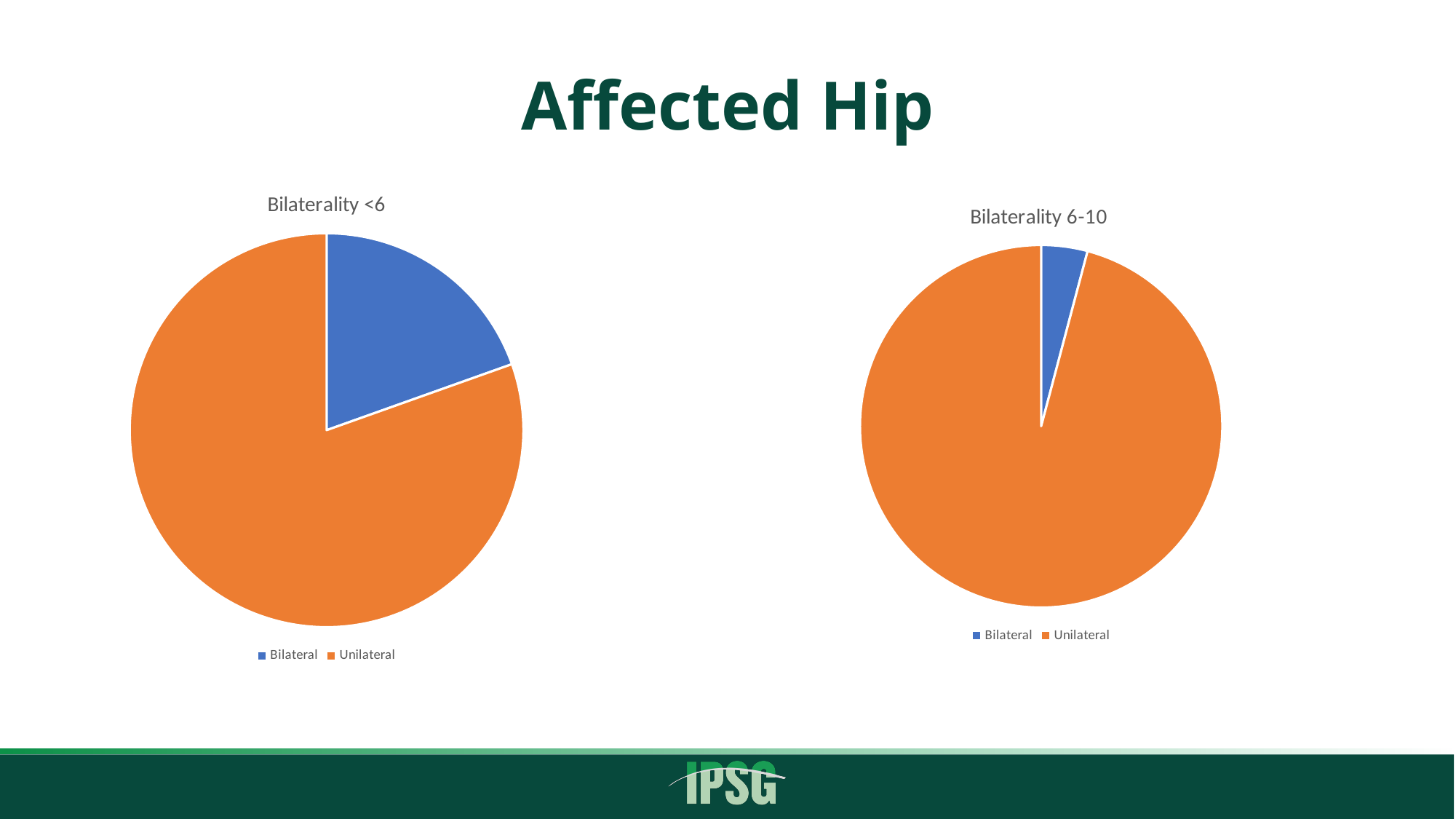
How many entries does the legend of the 'Bilaterality 6-10' chart list? 2 In the 'Bilaterality 6-10' chart, which slice is the largest? Unilateral In the 'Bilaterality 6-10' chart, which slice is the smallest? Bilateral What kind of chart is the 'Bilaterality 6-10' chart? pie chart What colour is the Bilateral slice in the 'Bilaterality <6' chart? blue In the 'Bilaterality <6' chart, which slice is the smallest? Bilateral What kind of chart is the 'Bilaterality <6' chart? pie chart In the 'Bilaterality 6-10' chart, is the Unilateral slice larger or smaller than the Bilateral slice? larger In the 'Bilaterality <6' chart, is the Bilateral slice larger or smaller than the Unilateral slice? smaller How many slices does the 'Bilaterality <6' pie chart have? 2 In the 'Bilaterality <6' chart, which slice is the largest? Unilateral What is the title of the chart on the right side of the slide? Bilaterality 6-10